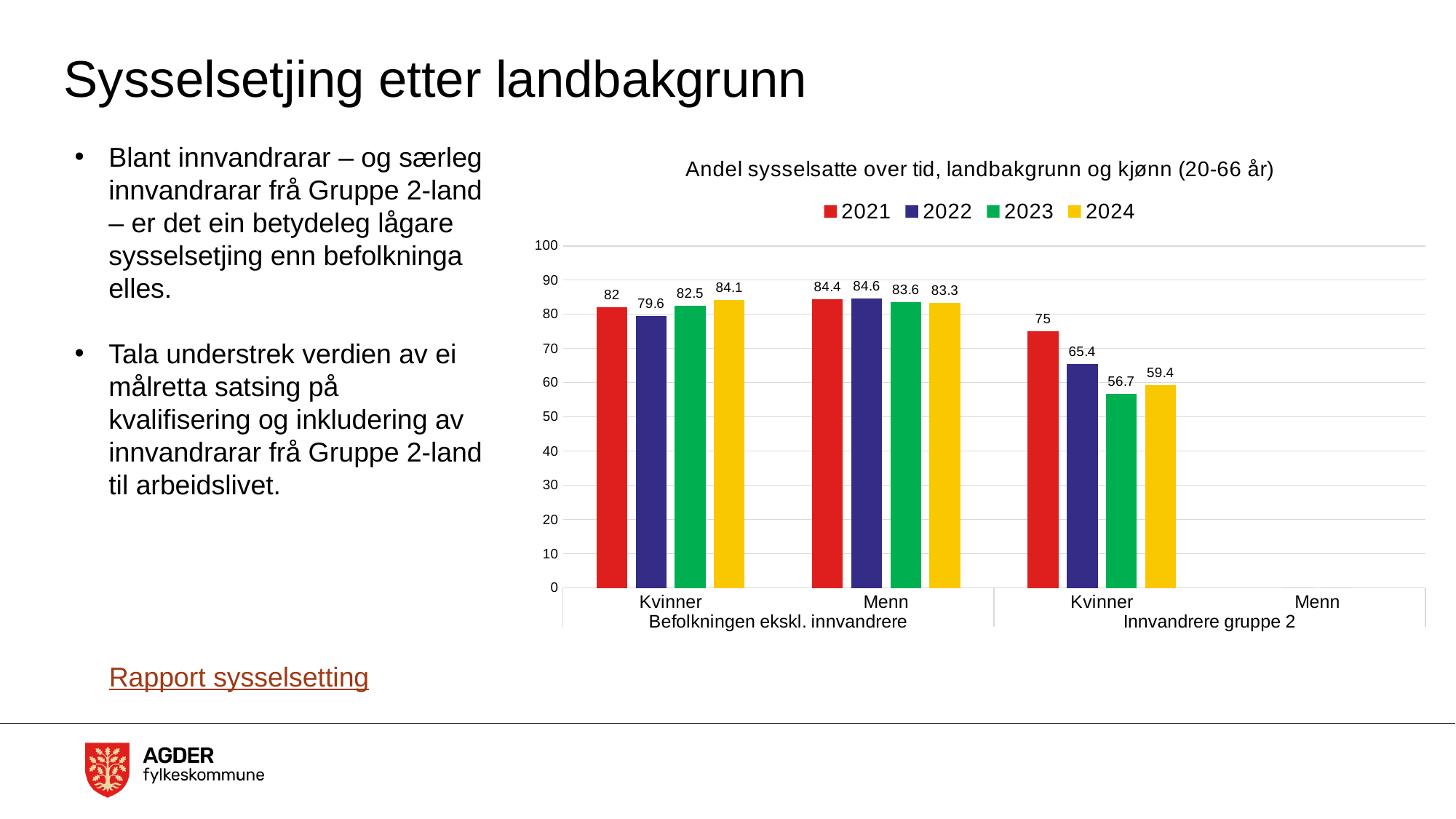
What is the 2024 value for Kvinner in the Befolkningen ekskl. innvandrere group? 84.1 What is the 2023 value for Menn in the Befolkningen ekskl. innvandrere group? 83.6 What is the title of the chart? Andel sysselsatte over tid, landbakgrunn og kjønn (20-66 år) Do the values for Kvinner in the Befolkningen ekskl. innvandrere group rise or fall from 2022 to 2024? Rise What kind of chart is shown on the slide? Bar chart What is the difference between the 2021 and 2023 values for Kvinner in the Innvandrere gruppe 2 group? 18.3 How many series does the legend list? 4 Which is larger: the 2022 value for Kvinner or the 2022 value for Menn in the Befolkningen ekskl. innvandrere group? Menn Which year has the lowest value for Kvinner in the Innvandrere gruppe 2 group? 2023 What is the 2021 value for Kvinner in the Innvandrere gruppe 2 group? 75 Which year has the highest value for Menn in the Befolkningen ekskl. innvandrere group? 2022 What is the 2022 value for Kvinner in the Innvandrere gruppe 2 group? 65.4